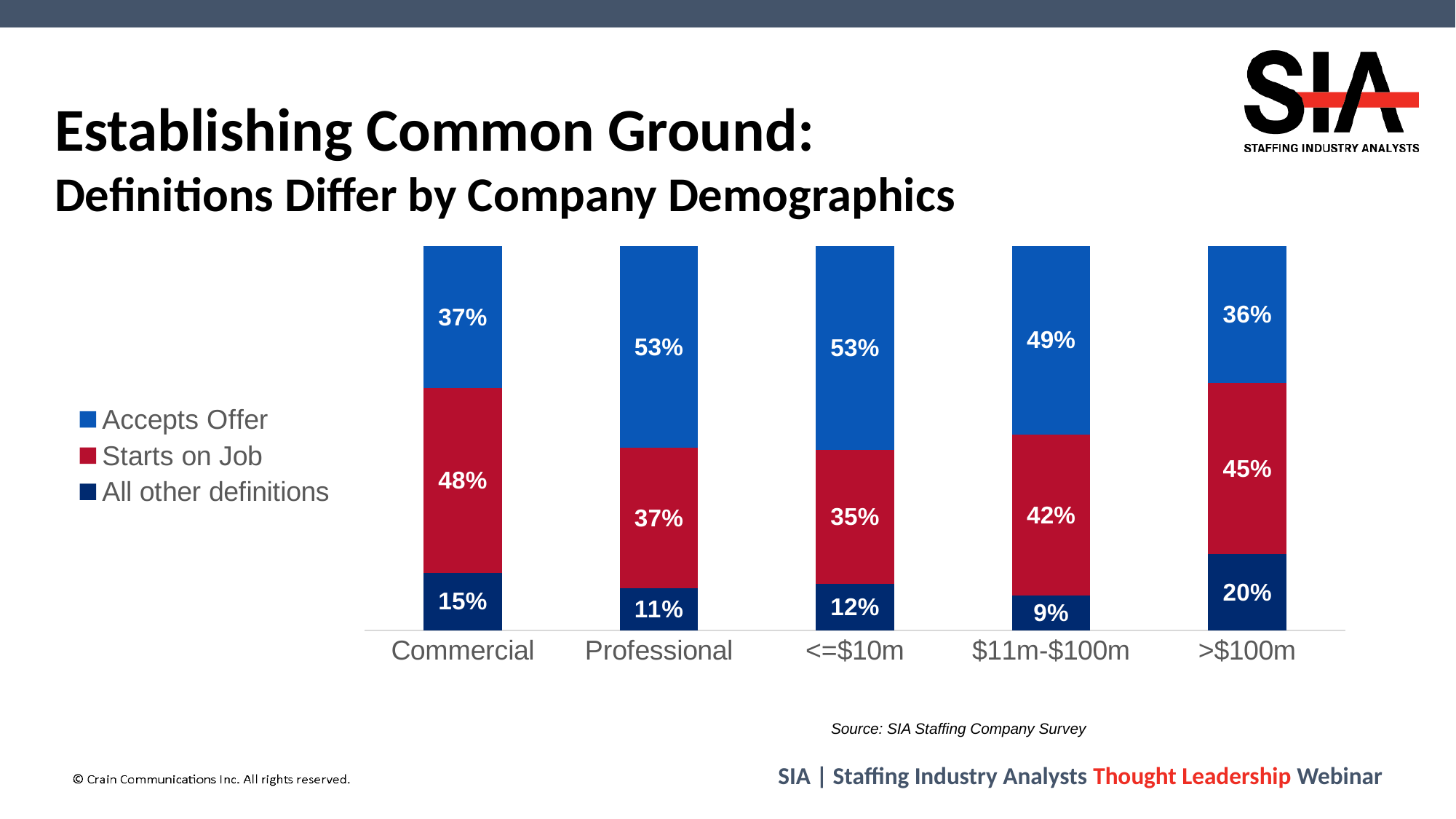
Which category has the lowest value for All other definitions? $11m-$100m What is the value for Starts on Job in the $11m-$100m category? 42% What is the total of the stacked bar for the Commercial category? 100% Which series is shown in red in the legend? Starts on Job How many series does the legend list? 3 How many categories are shown on the x axis? 5 What is the value for Accepts Offer in the Commercial category? 37% What kind of chart is shown on the slide? Stacked bar chart Which is larger: Starts on Job for Professional or Starts on Job for <=$10m? Professional What is the value for All other definitions in the >$100m category? 20% Which category has the highest value for Starts on Job? Commercial What is the difference between the Accepts Offer values for Professional and >$100m? 17%